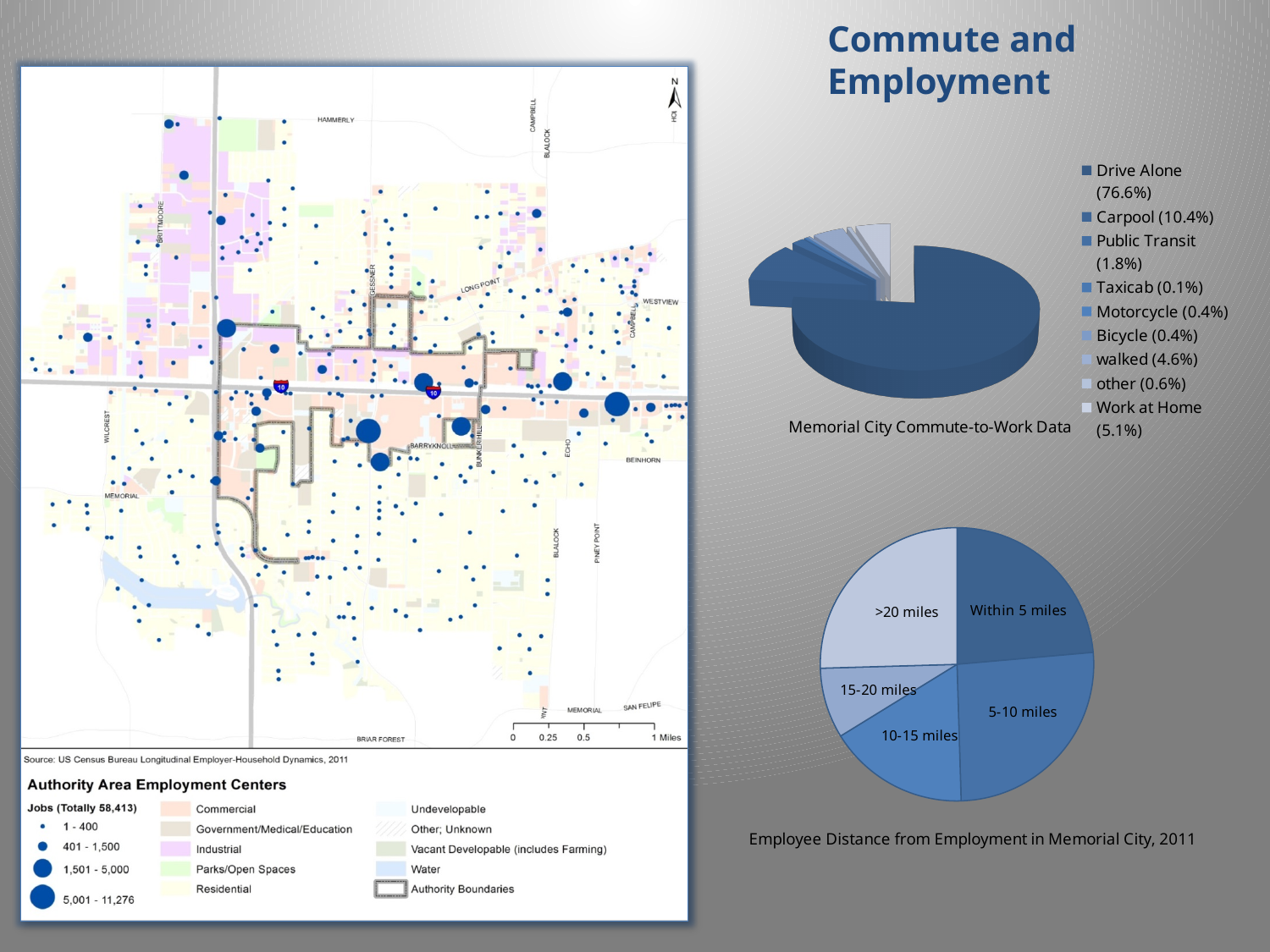
In the Employee Distance from Employment in Memorial City, 2011 chart, which distance category has the smallest slice? 15-20 miles In the Memorial City Commute-to-Work Data chart, which commute mode has the largest share? Drive Alone What kind of chart is the Employee Distance from Employment in Memorial City, 2011 chart? Pie chart In the Employee Distance from Employment in Memorial City, 2011 chart, which slice is larger: 10-15 miles or 15-20 miles? 10-15 miles In the Memorial City Commute-to-Work Data chart, what is the percentage for Carpool? 10.4% In the Memorial City Commute-to-Work Data chart, what percentage of commuters drive alone? 76.6% In the Memorial City Commute-to-Work Data chart, which is larger: walked or Work at Home? Work at Home How many commute modes are listed in the legend of the Memorial City Commute-to-Work Data chart? 9 How many distance categories are shown in the Employee Distance from Employment in Memorial City, 2011 chart? 5 In the Memorial City Commute-to-Work Data chart, which commute mode has the smallest share? Taxicab In the Memorial City Commute-to-Work Data chart, what is the percentage for Work at Home? 5.1% In the Memorial City Commute-to-Work Data chart, how many percentage points higher is Drive Alone than Carpool? 66.2 percentage points